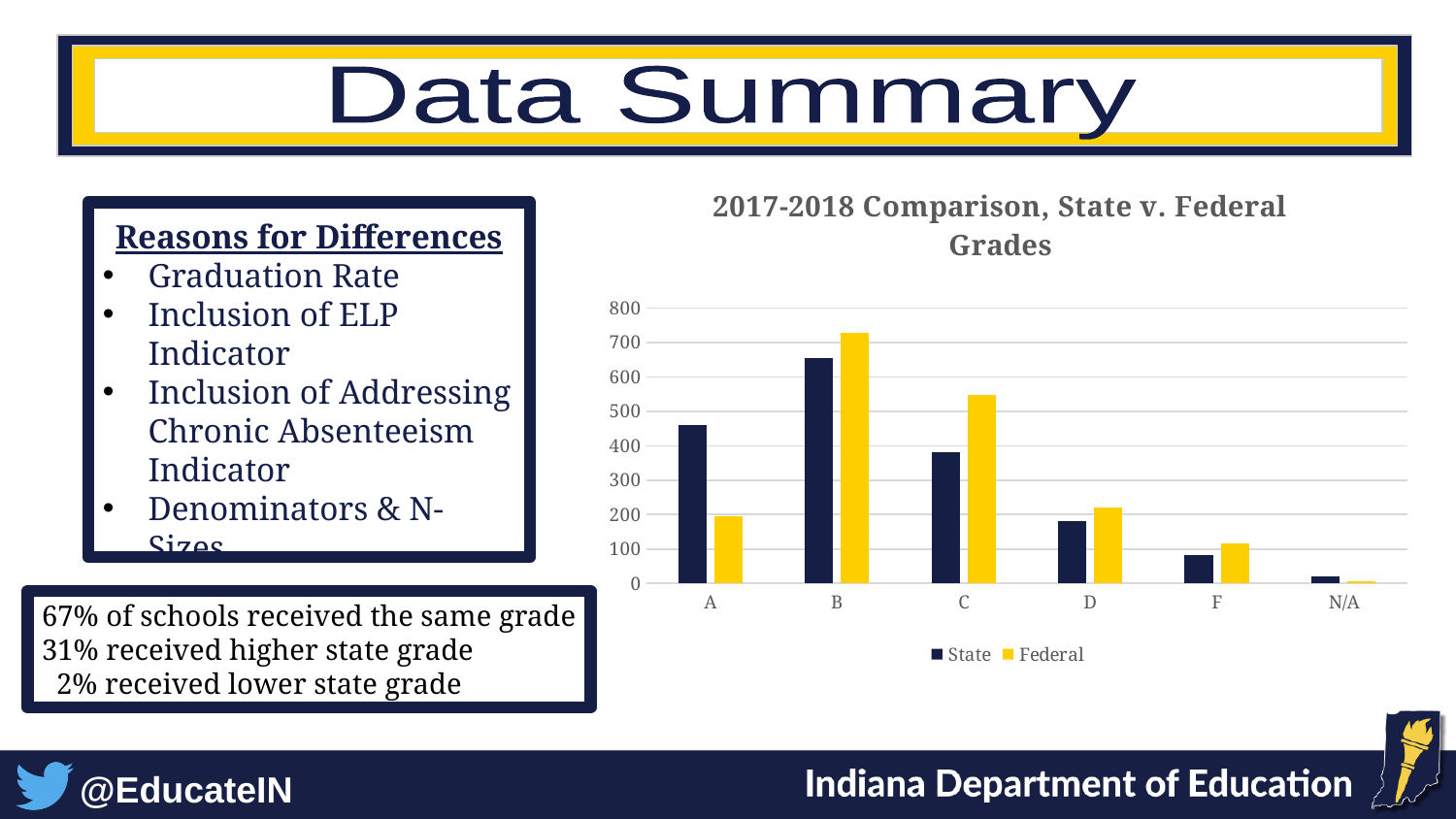
Is the State value for grade A greater or less than 400? greater How many series does the legend of the chart list? 2 How many grade categories are shown on the x axis of the chart? 6 Is the Federal value for grade C greater or less than 500? greater Is the Federal value for grade A greater or less than 300? less Which grade category has the highest State value? B What kind of chart is shown on the slide? Bar chart For grade A, which is larger, the State value or the Federal value? State For grade B, which is larger, the State value or the Federal value? Federal Which grade category has the lowest Federal value? N/A What is the title of the chart? 2017-2018 Comparison, State v. Federal Grades Which grade category has the highest Federal value? B